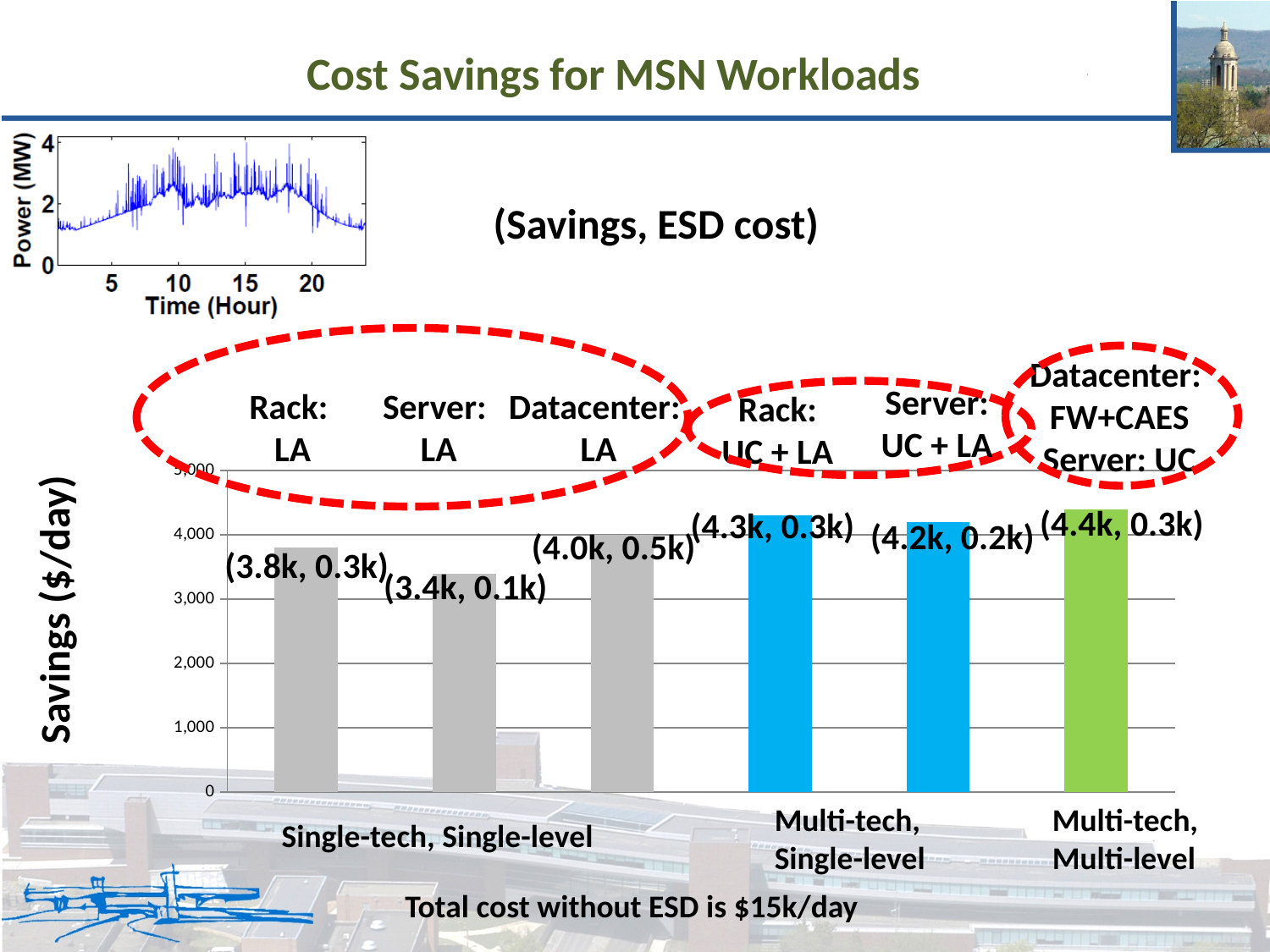
In the bar chart, what is the savings value for Server: UC + LA? 4.2k What is the x-axis label of the small chart in the top-left corner of the slide? Time (Hour) In the bar chart, what is the difference in savings between Rack: UC + LA and Rack: LA? 0.5k In the bar chart, what is the savings value for Rack: LA? 3.8k In the bar chart, is the savings value for Server: LA greater or less than 4,000? less How many bars are plotted in the savings bar chart? 6 In the bar chart, what is the ESD cost shown for Datacenter: LA? 0.5k What is the y-axis label of the large bar chart? Savings ($/day) In the bar chart, which configuration has the highest savings? Datacenter: FW+CAES Server: UC In the bar chart, which configuration has the lowest savings? Server: LA What kind of chart is the large chart showing savings in $/day? bar chart In the bar chart, which has higher savings, Datacenter: LA or Rack: LA? Datacenter: LA